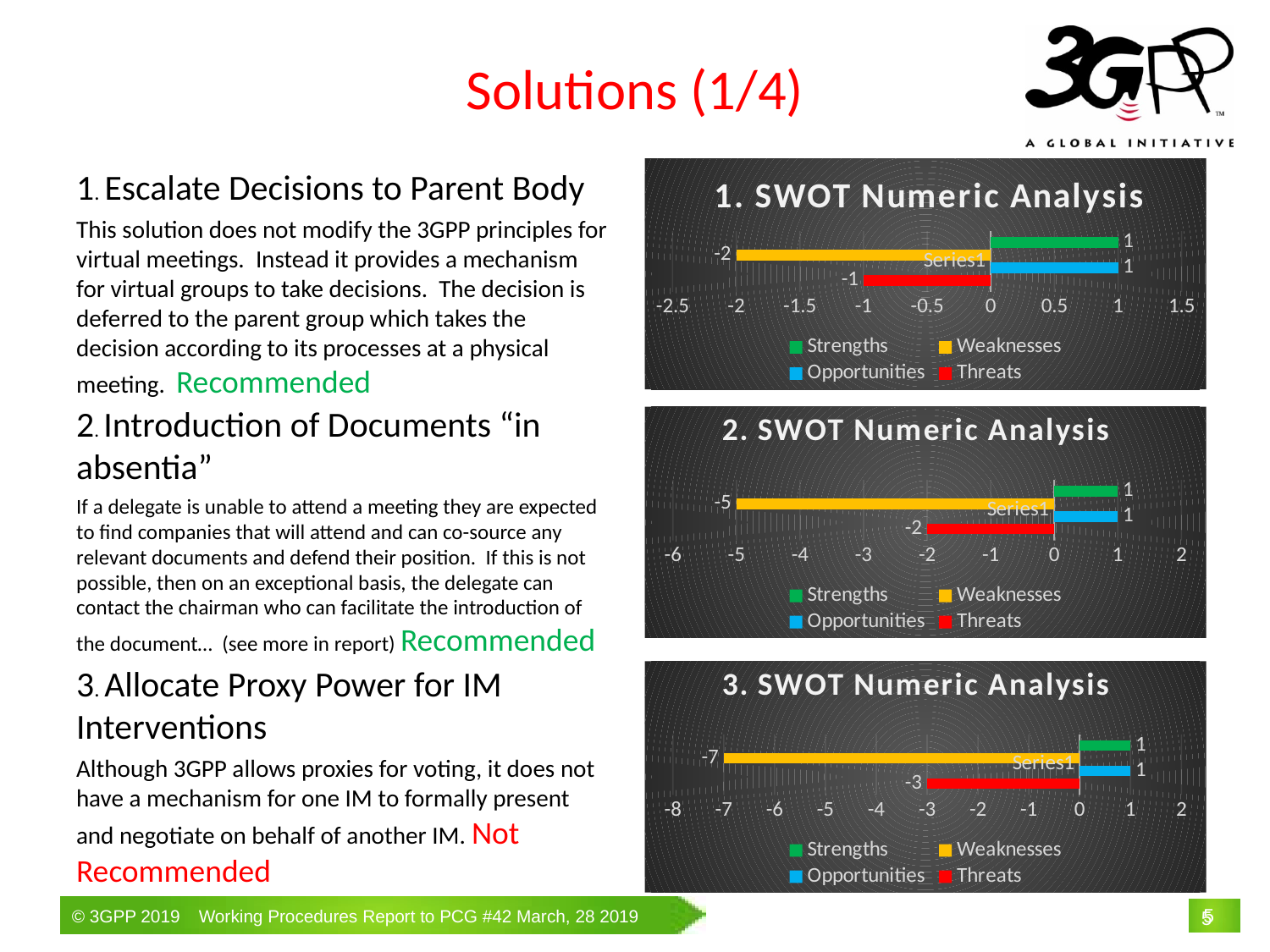
In the chart titled "3. SWOT Numeric Analysis", which is larger, the value for Threats or the value for Weaknesses? Threats In the chart titled "3. SWOT Numeric Analysis", what is the value for Weaknesses? -7 In the chart titled "3. SWOT Numeric Analysis", which series has the lowest value? Weaknesses In the chart titled "2. SWOT Numeric Analysis", what is the difference between the Weaknesses value and the Threats value? 3 In the chart titled "1. SWOT Numeric Analysis", what is the value for Weaknesses? -2 In the chart titled "1. SWOT Numeric Analysis", what colour represents Opportunities in the legend? Blue In the chart titled "2. SWOT Numeric Analysis", what is the value for Weaknesses? -5 In the chart titled "3. SWOT Numeric Analysis", what is the value for Strengths? 1 How many series does the legend list in the chart titled "1. SWOT Numeric Analysis"? 4 What kind of chart is the chart titled "2. SWOT Numeric Analysis"? Bar chart In the chart titled "1. SWOT Numeric Analysis", what is the value for Threats? -1 In the chart titled "2. SWOT Numeric Analysis", what is the value for Threats? -2